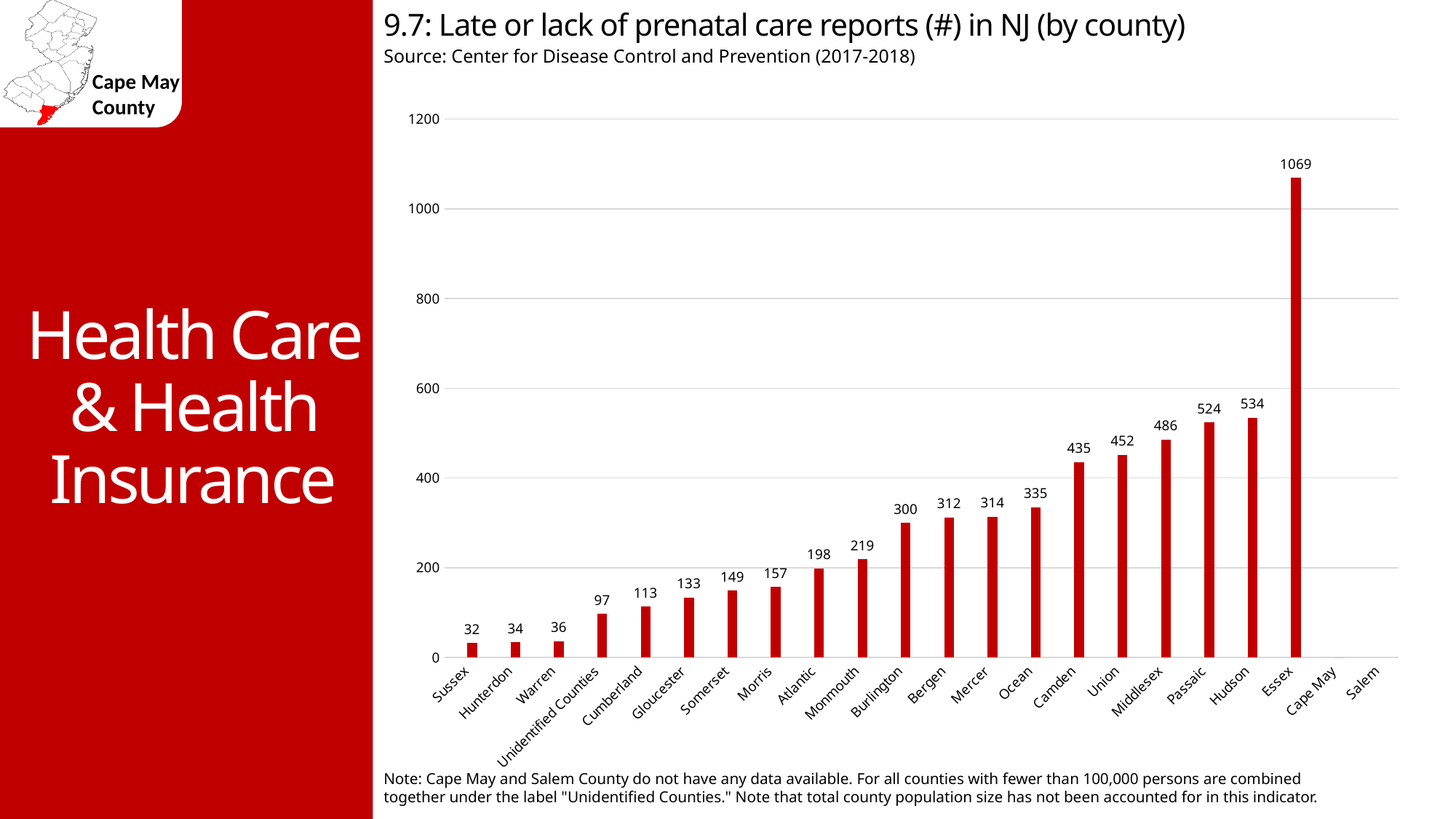
What kind of chart is shown on the slide? Bar chart What is the difference between the values for Hudson and Passaic? 10 What is the value shown for Unidentified Counties? 97 What is the difference between the values for Essex and Hudson? 535 What is the number of late or lack of prenatal care reports for Essex? 1069 Do the values generally rise or fall moving from left to right along the x axis? Rise What is the value shown for Cumberland? 113 Which has a larger value, Camden or Ocean? Camden How many county labels are shown on the x axis? 22 Is the value for Middlesex greater or less than 400? greater Which county has the highest number of late or lack of prenatal care reports? Essex Which county with a plotted bar has the lowest value? Sussex